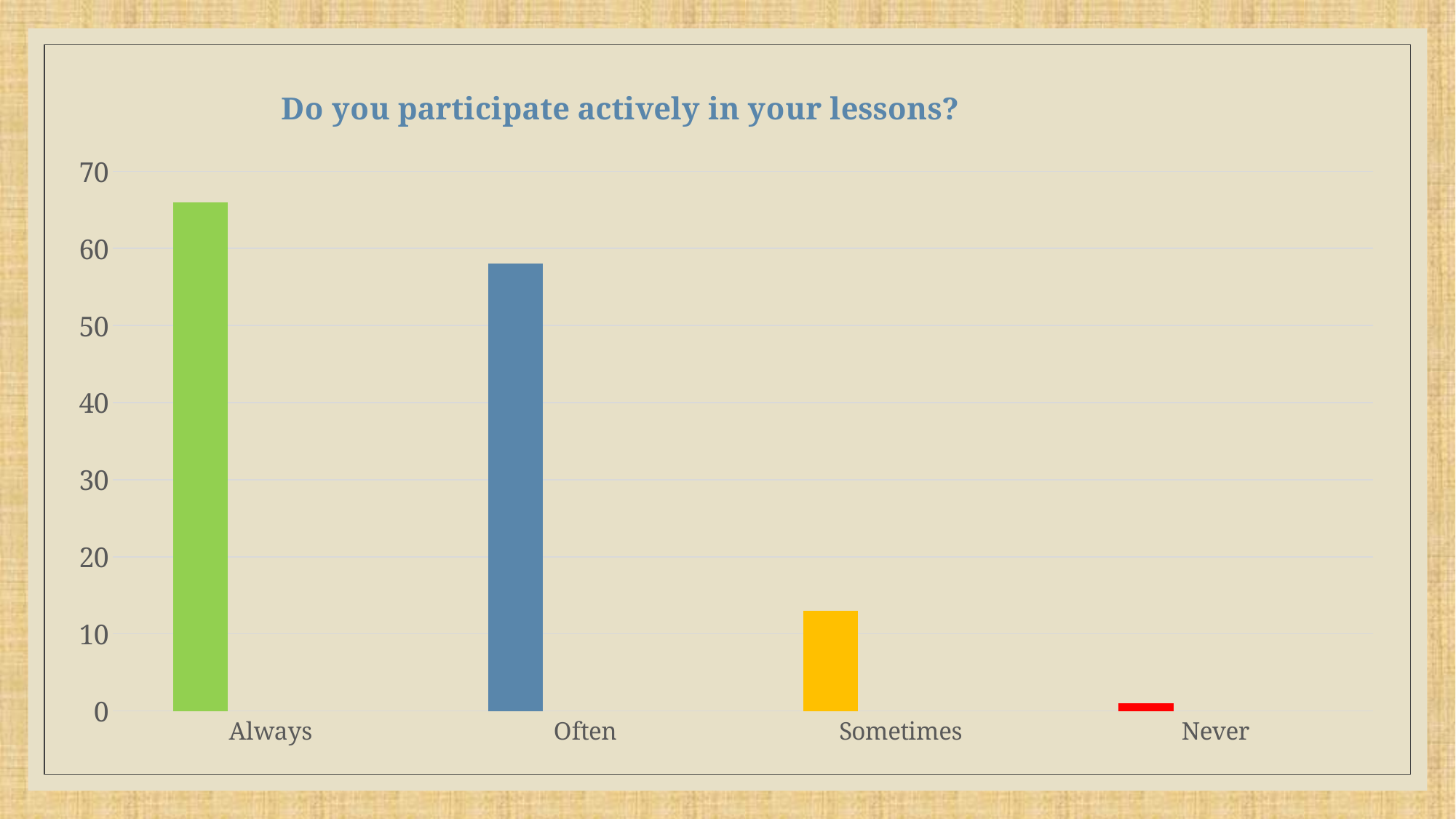
Is the value for Never greater or less than 10? less Which category has the highest value? Always Do the values rise or fall moving from Always to Never along the x axis? fall What kind of chart is shown on the slide? bar chart What is the title of the chart? Do you participate actively in your lessons? How many categories are shown on the x axis of the chart? 4 Is the value for Often greater or less than 60? less Is the value for Always greater or less than 60? greater Which category has the lowest value? Never Which is larger, the value for Often or the value for Sometimes? Often